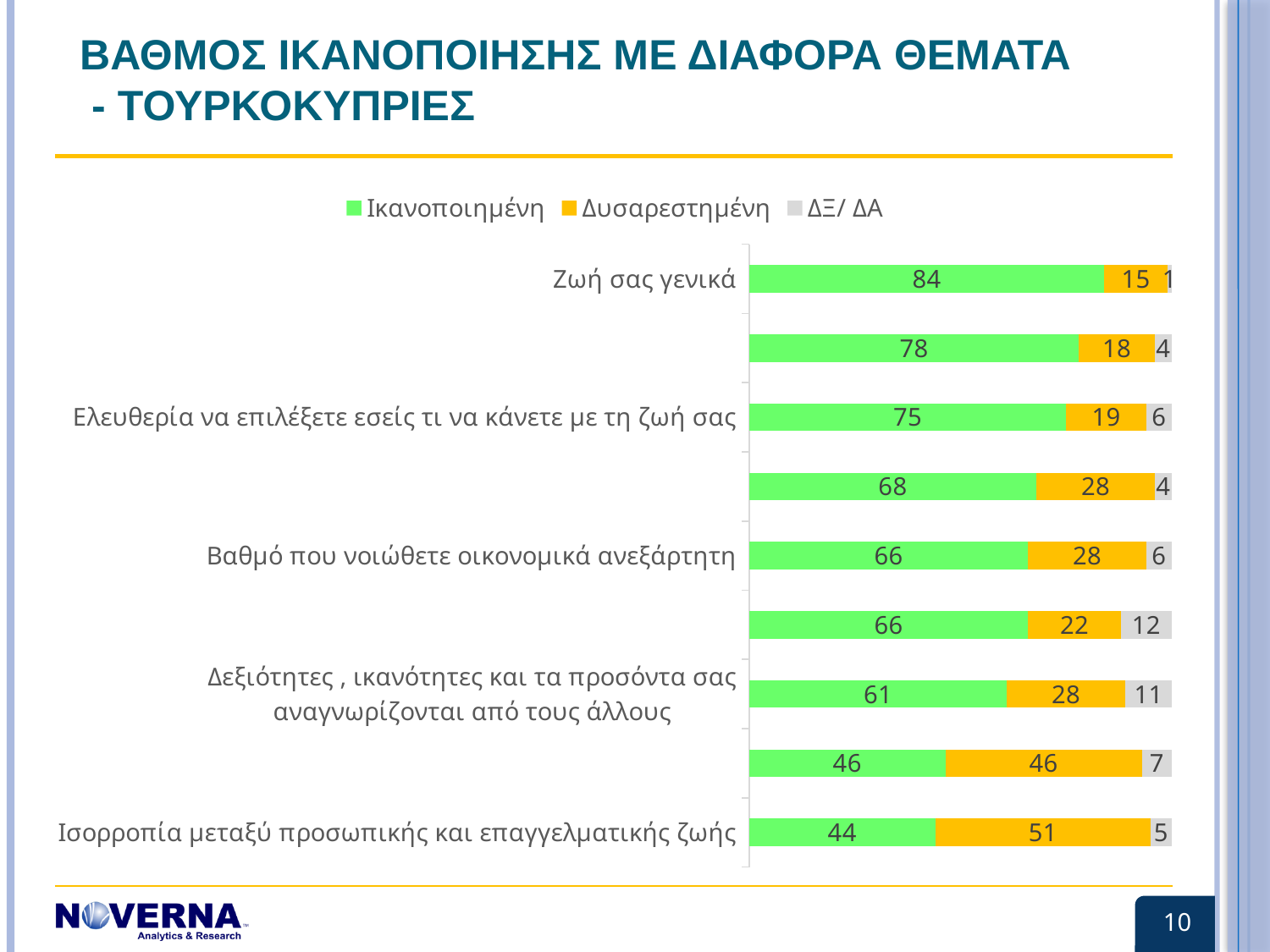
How many series does the legend list? 3 Which is larger for Ισορροπία μεταξύ προσωπικής και επαγγελματικής ζωής: Ικανοποιημένη or Δυσαρεστημένη? Δυσαρεστημένη What is the value of ΔΞ/ ΔΑ for Δεξιότητες, ικανότητες και τα προσόντα σας αναγνωρίζονται από τους άλλους? 11 What is the value of Ικανοποιημένη for Ελευθερία να επιλέξετε εσείς τι να κάνετε με τη ζωή σας? 75 What is the total of the stacked bar for Βαθμό που νοιώθετε οικονομικά ανεξάρτητη? 100 Which labelled category has the highest Ικανοποιημένη value? Ζωή σας γενικά Which labelled category has the lowest Ικανοποιημένη value? Ισορροπία μεταξύ προσωπικής και επαγγελματικής ζωής What is the value of Ικανοποιημένη for Ζωή σας γενικά? 84 What is the difference between the Ικανοποιημένη values for Ζωή σας γενικά and Ισορροπία μεταξύ προσωπικής και επαγγελματικής ζωής? 40 What is the value of Δυσαρεστημένη for Βαθμό που νοιώθετε οικονομικά ανεξάρτητη? 28 What is the value of Δυσαρεστημένη for Ισορροπία μεταξύ προσωπικής και επαγγελματικής ζωής? 51 What kind of chart is shown on the slide? Stacked bar chart